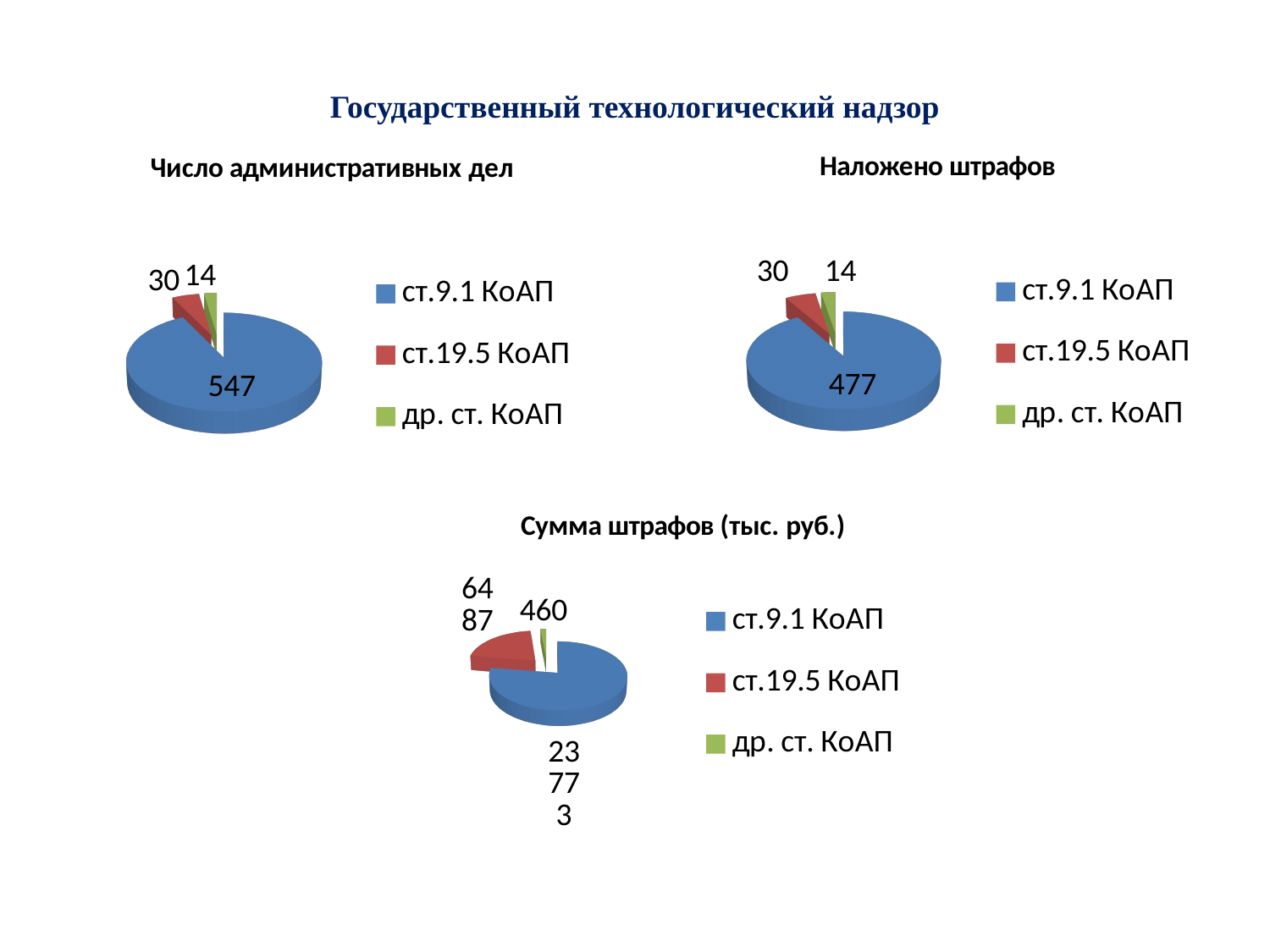
In the chart titled "Число административных дел", what is the value for ст.19.5 КоАП? 30 In the chart titled "Сумма штрафов (тыс. руб.)", which is larger: the slice for ст.19.5 КоАП or the slice for др. ст. КоАП? ст.19.5 КоАП In the chart titled "Наложено штрафов", what is the value for ст.9.1 КоАП? 477 In the chart titled "Число административных дел", what is the value for ст.9.1 КоАП? 547 How many pie charts are shown on the slide? 3 In the chart titled "Число административных дел", what is the value for др. ст. КоАП? 14 In the chart titled "Наложено штрафов", which category has the smallest slice? др. ст. КоАП In the chart titled "Наложено штрафов", what is the total of all three slices? 521 In the chart titled "Число административных дел", what is the difference between the values for ст.19.5 КоАП and др. ст. КоАП? 16 What kind of chart is the one titled "Число административных дел"? Pie chart In the chart titled "Сумма штрафов (тыс. руб.)", which category has the largest slice? ст.9.1 КоАП How many entries does the legend of the chart titled "Сумма штрафов (тыс. руб.)" list? 3